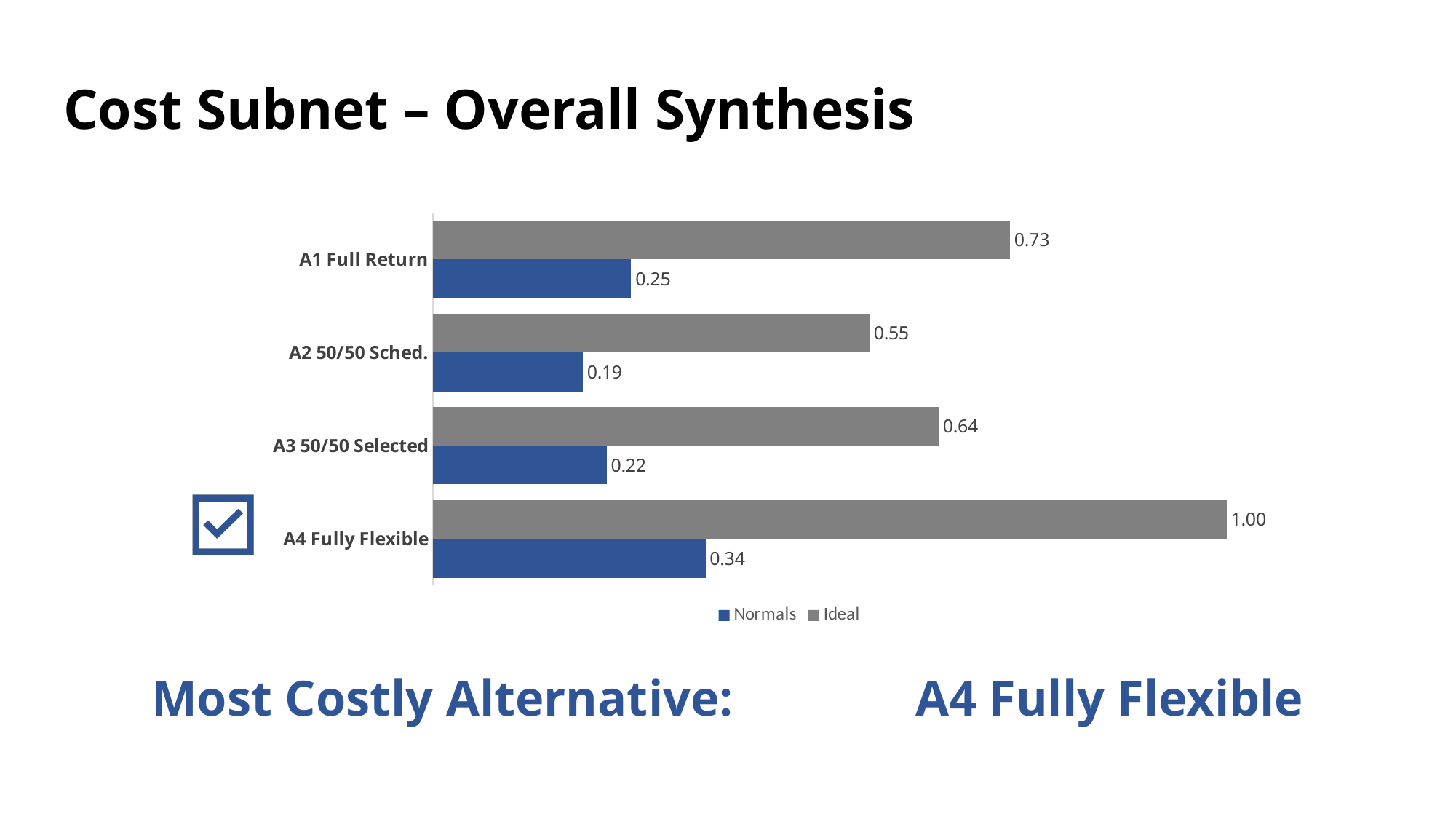
Which category has the highest Ideal value? A4 Fully Flexible What is the Ideal value for A1 Full Return? 0.73 Which series is shown in grey in the legend? Ideal How many categories are shown on the chart? 4 What is the difference between the Ideal and Normals values for A1 Full Return? 0.48 What is the Ideal value for A4 Fully Flexible? 1.00 Which is larger, the Ideal value for A2 50/50 Sched. or the Ideal value for A3 50/50 Selected? A3 50/50 Selected What is the Normals value for A3 50/50 Selected? 0.22 Which category has the lowest Normals value? A2 50/50 Sched. What kind of chart is shown on the slide? Bar chart How many series does the legend list? 2 What is the Normals value for A2 50/50 Sched.? 0.19